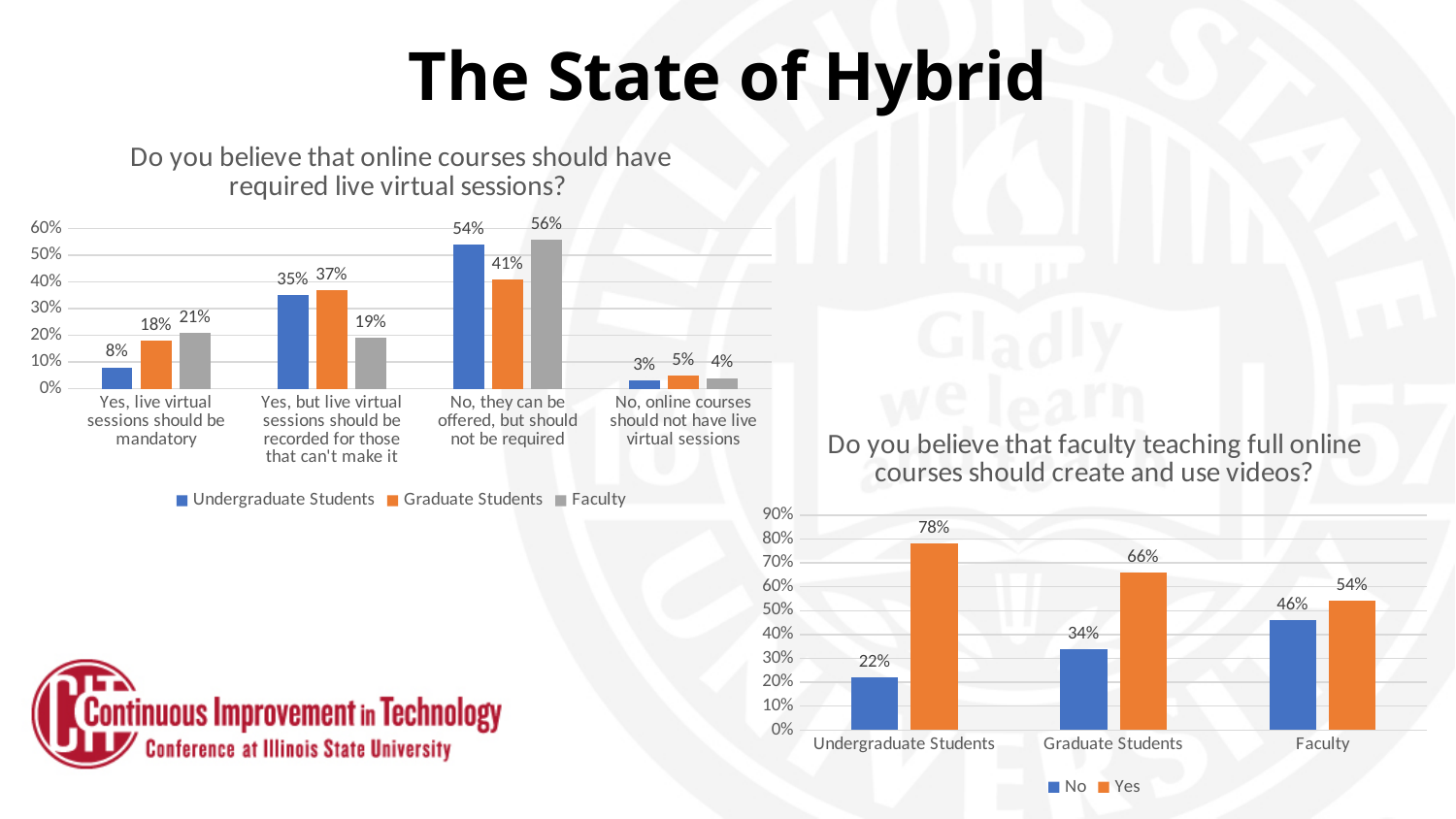
In the chart 'Do you believe that faculty teaching full online courses should create and use videos?', what is the 'Yes' value for Undergraduate Students? 78% In the chart 'Do you believe that online courses should have required live virtual sessions?', what is the difference between the Graduate Students and Undergraduate Students values in the category 'Yes, live virtual sessions should be mandatory'? 10% In the chart 'Do you believe that faculty teaching full online courses should create and use videos?', what is the 'No' value for Faculty? 46% In the chart 'Do you believe that online courses should have required live virtual sessions?', what is the value for Faculty in the category 'No, they can be offered, but should not be required'? 56% In the chart 'Do you believe that online courses should have required live virtual sessions?', how many series does the legend list? 3 In the chart 'Do you believe that faculty teaching full online courses should create and use videos?', what is the difference between the 'Yes' and 'No' values for Graduate Students? 32% In the chart 'Do you believe that online courses should have required live virtual sessions?', which category has the lowest value for Faculty? No, online courses should not have live virtual sessions What kind of chart is 'Do you believe that faculty teaching full online courses should create and use videos?'? Bar chart In the chart 'Do you believe that online courses should have required live virtual sessions?', which category has the highest value for Graduate Students? No, they can be offered, but should not be required In the chart 'Do you believe that faculty teaching full online courses should create and use videos?', which group has the highest 'No' value? Faculty In the chart 'Do you believe that online courses should have required live virtual sessions?', how many categories are shown on the x axis? 4 In the chart 'Do you believe that online courses should have required live virtual sessions?', what is the value for Undergraduate Students in the category 'Yes, live virtual sessions should be mandatory'? 8%